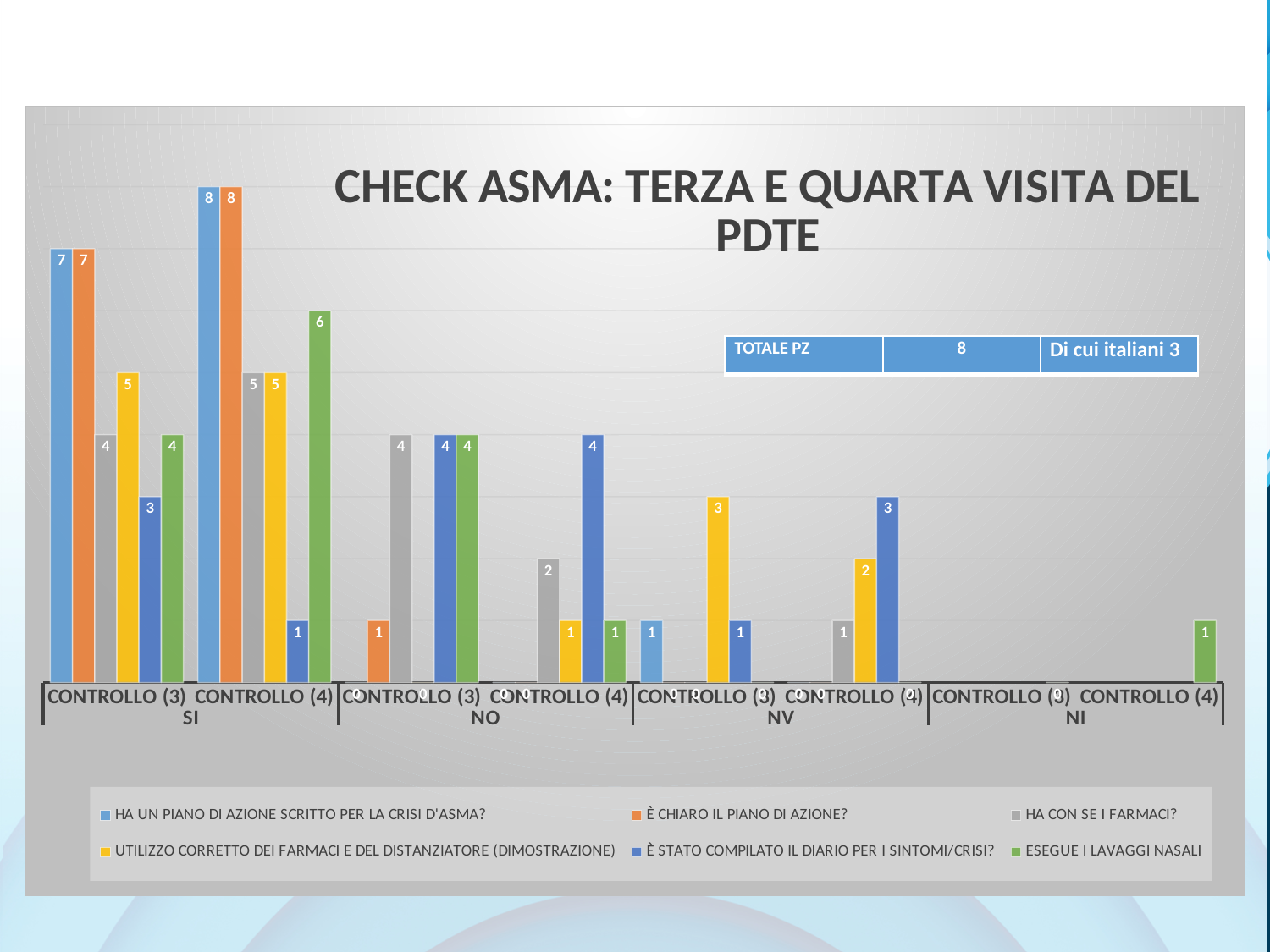
How many series does the legend list? 6 What is the value for HA CON SE I FARMACI? at CONTROLLO (4) in the NO group? 2 What is the value for ESEGUE I LAVAGGI NASALI at CONTROLLO (3) in the SI group? 4 What is the value for ESEGUE I LAVAGGI NASALI at CONTROLLO (4) in the NI group? 1 What is the value for UTILIZZO CORRETTO DEI FARMACI E DEL DISTANZIATORE (DIMOSTRAZIONE) at CONTROLLO (3) in the NV group? 3 Which series has the highest value at CONTROLLO (4) in the NO group? È STATO COMPILATO IL DIARIO PER I SINTOMI/CRISI? In the SI group, is the value for È STATO COMPILATO IL DIARIO PER I SINTOMI/CRISI? larger at CONTROLLO (3) or CONTROLLO (4)? CONTROLLO (3) How many main answer groups (SI, NO, NV, NI) are shown on the x axis? 4 What kind of chart is shown on the slide? Bar chart What is the title of the chart? CHECK ASMA: TERZA E QUARTA VISITA DEL PDTE What is the difference between the ESEGUE I LAVAGGI NASALI values at CONTROLLO (4) and CONTROLLO (3) in the SI group? 2 What is the value for HA UN PIANO DI AZIONE SCRITTO PER LA CRISI D'ASMA? at CONTROLLO (4) in the SI group? 8